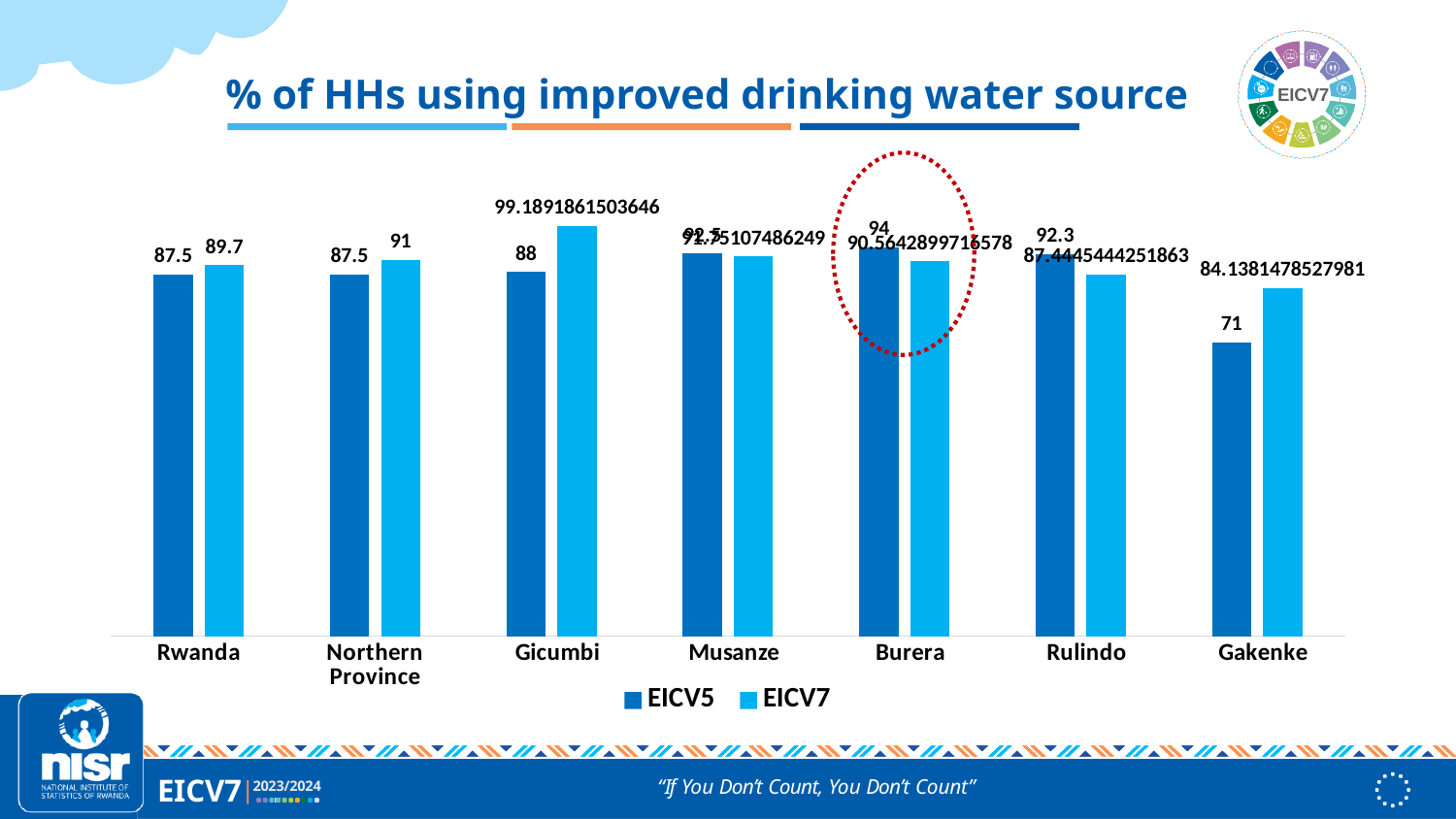
Which category has the lowest EICV5 value? Gakenke How many categories are shown on the x axis? 7 What is the EICV5 value for Gakenke? 71 What is the EICV5 value for Rulindo? 92.3 What is the EICV7 value for Gicumbi? 99.1891861503646 What is the EICV5 value for Northern Province? 87.5 What is the difference between the EICV7 and EICV5 values for Northern Province? 3.5 Which category is highlighted with a red dotted circle? Burera For Burera, which is larger, the EICV5 value or the EICV7 value? EICV5 Which category has the highest EICV7 value? Gicumbi What is the EICV7 value for Rwanda? 89.7 How many series does the legend list? 2